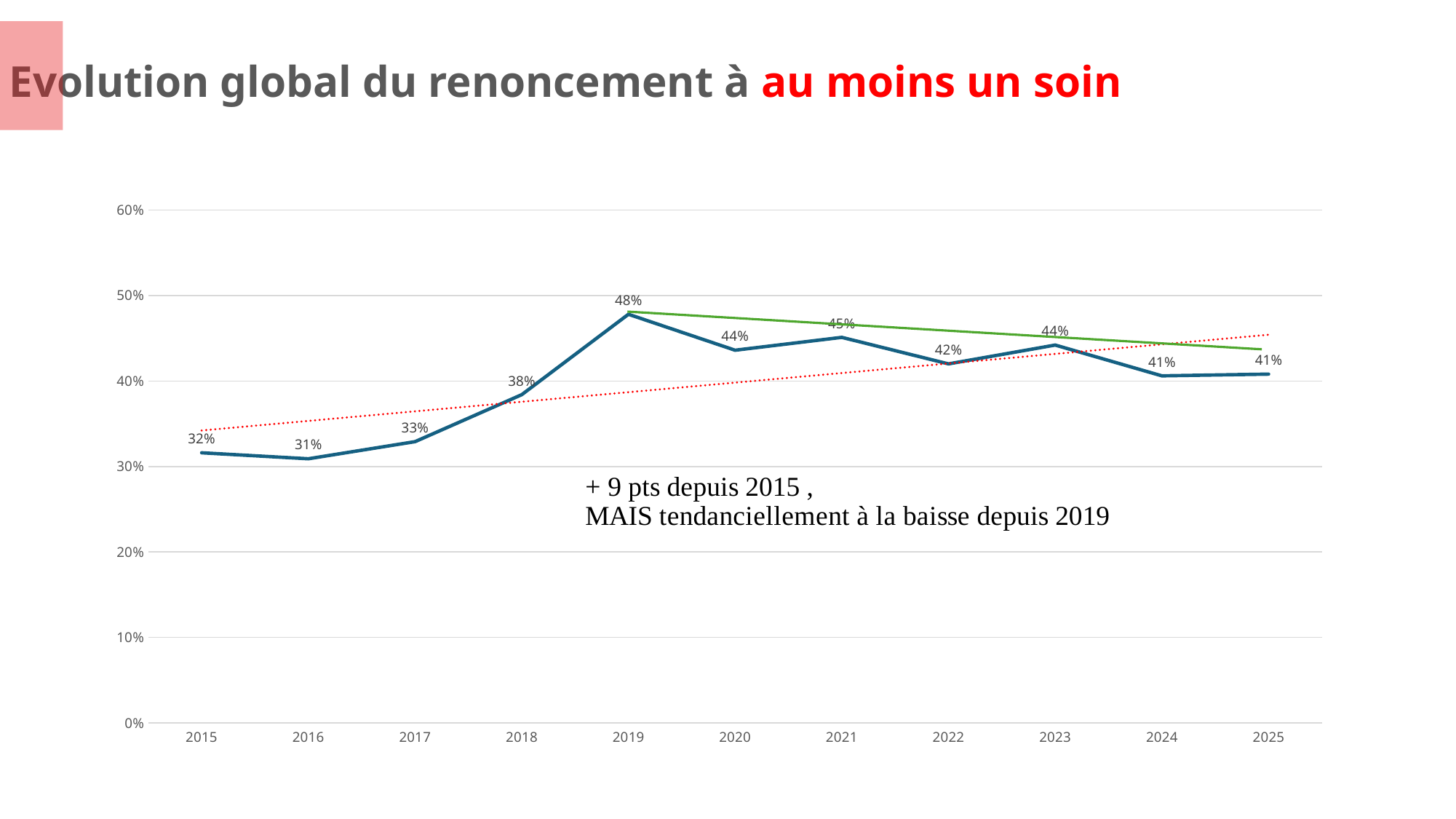
What is the value for 2025? 41% How many years are plotted on the x axis? 11 Is the value for 2018 greater or less than 40%? less Which is larger, the value for 2021 or the value for 2024? 2021 What is the value for 2019? 48% Which year has the highest value? 2019 What is the value for 2022? 42% What kind of chart is shown on the slide? line chart What is the difference between the values for 2018 and 2017? 5% What is the value for 2015? 32% What is the difference between the values for 2019 and 2015? 16% Which year has the lowest value? 2016